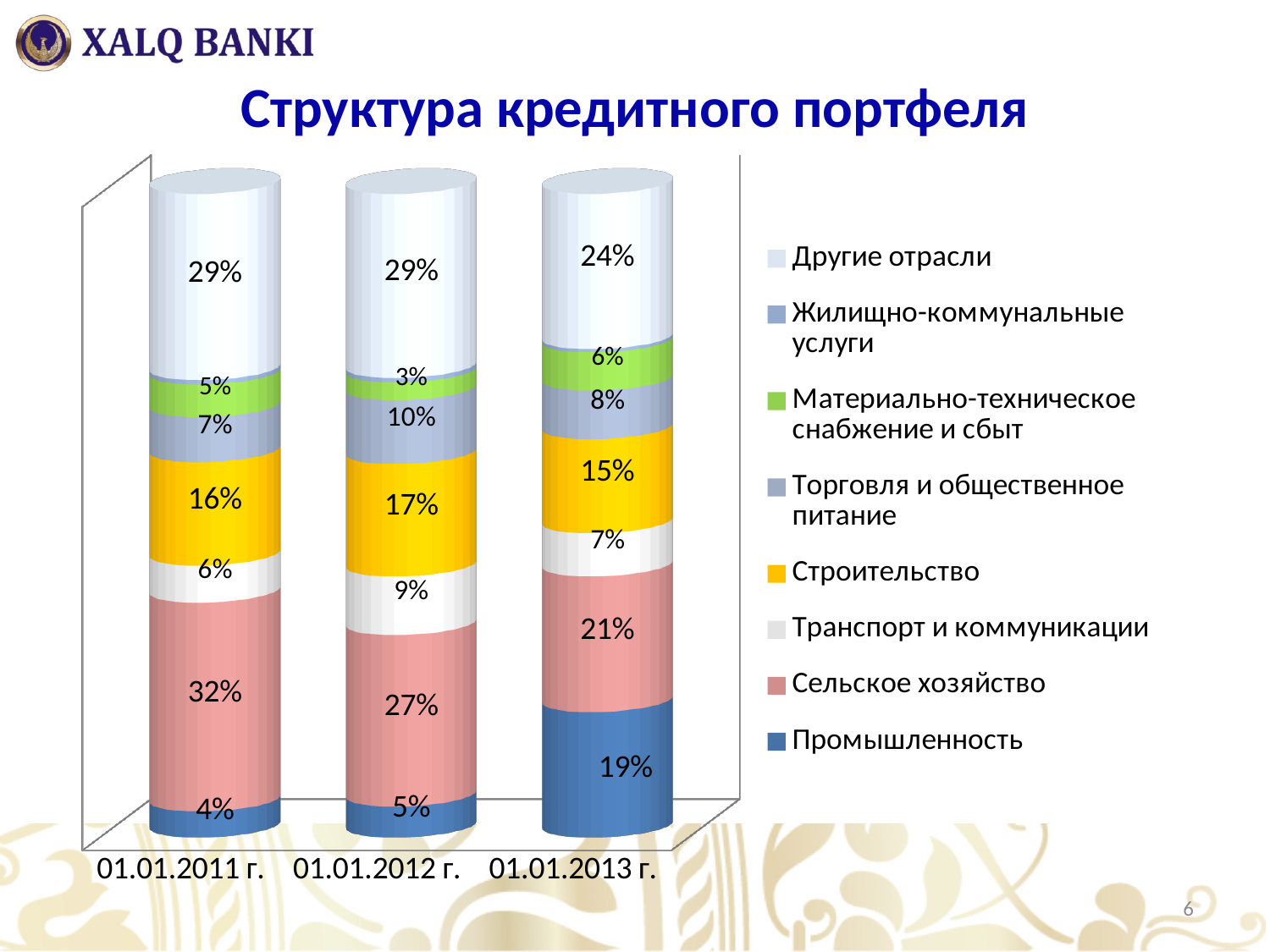
Does the share of Промышленность rise or fall from 01.01.2011 г. to 01.01.2013 г.? rise What is the share of Строительство on 01.01.2012 г.? 17% What is the share of Промышленность on 01.01.2013 г.? 19% What kind of chart is shown on the slide? stacked bar chart By how many percentage points did the share of Сельское хозяйство change from 01.01.2011 г. to 01.01.2013 г.? 11% On which date is the share of Промышленность the highest? 01.01.2013 г. What is the share of Сельское хозяйство on 01.01.2011 г.? 32% How many dates (categories) are shown along the x axis? 3 How many series does the legend list? 8 What is the share of Другие отрасли on 01.01.2013 г.? 24% On which date is the share of Сельское хозяйство the lowest? 01.01.2013 г. Which is larger on 01.01.2012 г.: the share of Торговля и общественное питание or the share of Транспорт и коммуникации? Торговля и общественное питание